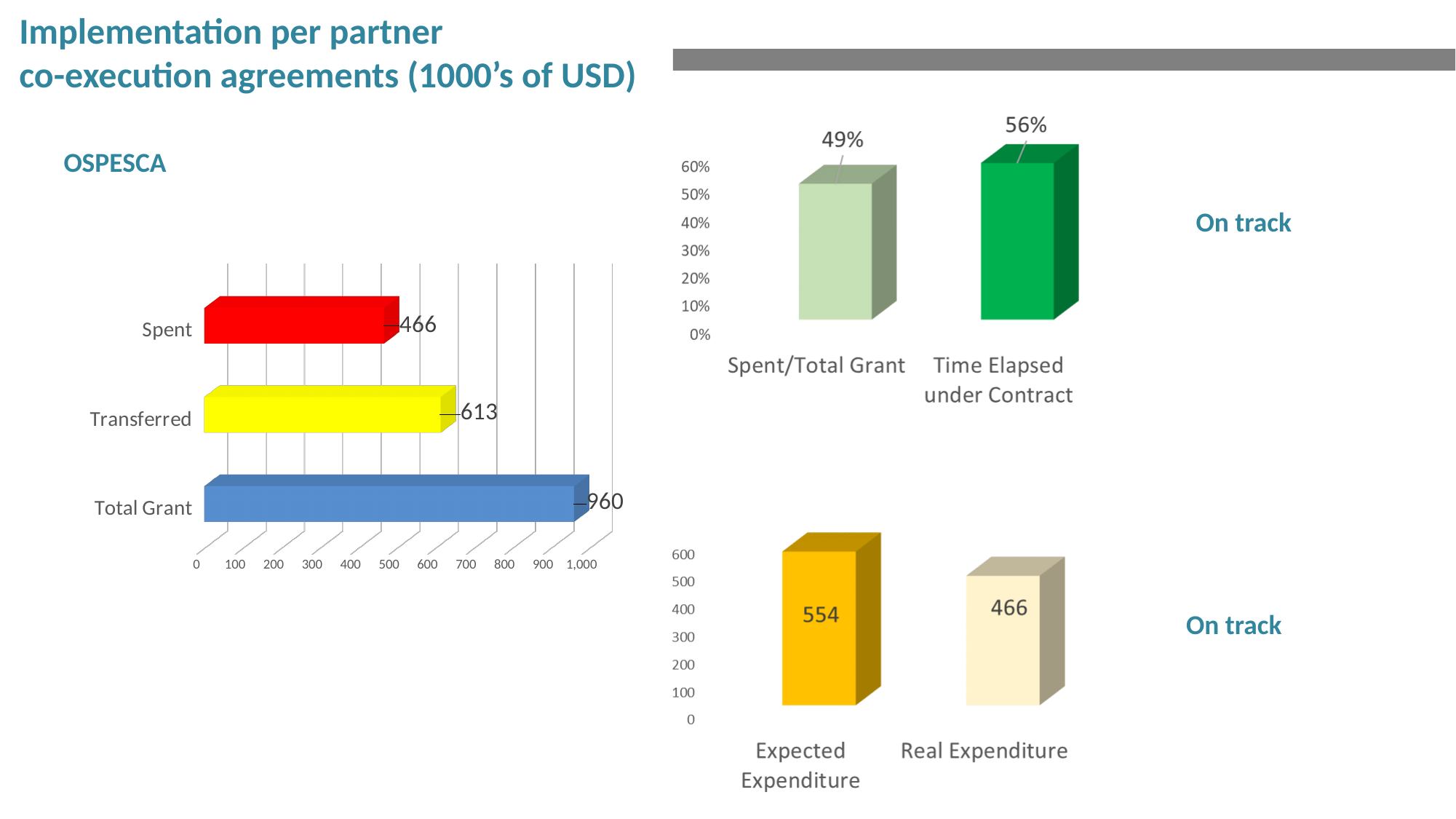
In the OSPESCA horizontal bar chart on the left, how many categories are shown? 3 In the OSPESCA horizontal bar chart on the left, what colour is the Transferred bar? Yellow In the bottom-right chart, what is the difference between Expected Expenditure and Real Expenditure? 88 In the bottom-right chart, what is the value for Expected Expenditure? 554 In the top-right chart, what is the value for Time Elapsed under Contract? 56% What kind of chart is the bottom-right chart? Bar chart In the top-right chart, which is larger, Spent/Total Grant or Time Elapsed under Contract? Time Elapsed under Contract In the top-right chart, what is the value for Spent/Total Grant? 49% In the OSPESCA horizontal bar chart on the left, what is the difference between Total Grant and Spent? 494 In the OSPESCA horizontal bar chart on the left, which category has the lowest value? Spent In the OSPESCA horizontal bar chart on the left, what is the value for Total Grant? 960 In the OSPESCA horizontal bar chart on the left, what is the value for Transferred? 613